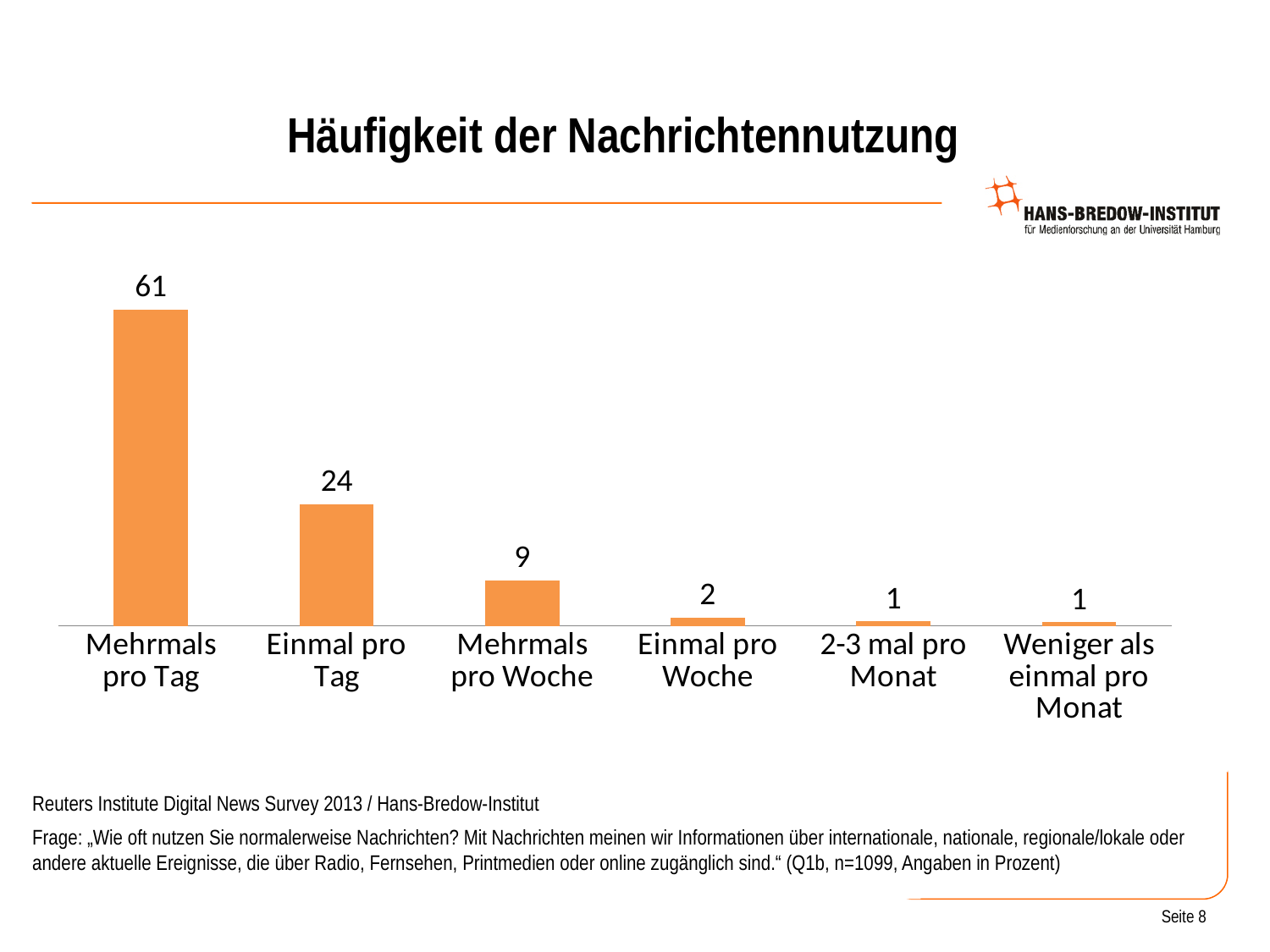
What is the value for "Einmal pro Tag"? 24 What is the value for "Mehrmals pro Woche"? 9 What is the value for "Einmal pro Woche"? 2 Do the values rise or fall from left to right along the x axis? Fall How many categories are shown on the x axis? 6 What kind of chart is shown on the slide? Bar chart What is the value for "Mehrmals pro Tag"? 61 What is the difference between the values for "Mehrmals pro Tag" and "Einmal pro Tag"? 37 What is the value for "2-3 mal pro Monat"? 1 Which category has the highest value? Mehrmals pro Tag What is the difference between the values for "Einmal pro Tag" and "Mehrmals pro Woche"? 15 Which is larger, the value for "Mehrmals pro Woche" or the value for "Einmal pro Woche"? Mehrmals pro Woche